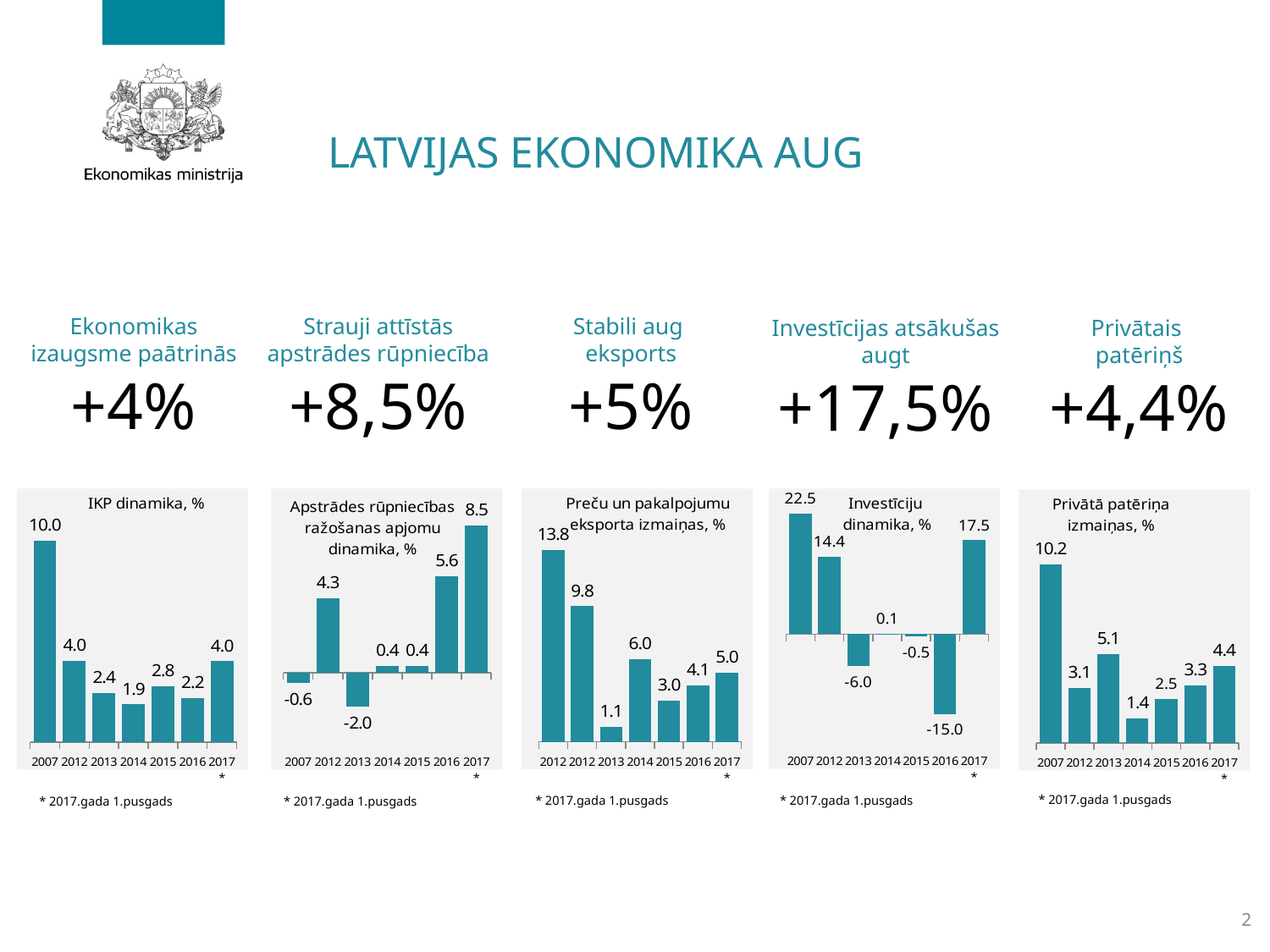
How many bars are plotted in the 'Privātā patēriņa izmaiņas, %' chart? 7 In the 'Preču un pakalpojumu eksporta izmaiņas, %' chart, which is larger, the value for 2015 or the value for 2016? 2016 In the 'Investīciju dinamika, %' chart, what is the value for 2016? -15.0 In the 'IKP dinamika, %' chart, which year has the lowest value? 2014 In the 'Apstrādes rūpniecības ražošanas apjomu dinamika, %' chart, what is the value for 2017? 8.5 In the 'Apstrādes rūpniecības ražošanas apjomu dinamika, %' chart, which year has the lowest value? 2013 In the 'Privātā patēriņa izmaiņas, %' chart, what is the value for 2013? 5.1 In the 'Investīciju dinamika, %' chart, which year has the highest value? 2007 What type of chart is the 'IKP dinamika, %' chart? Bar chart In the 'IKP dinamika, %' chart, what is the value for 2007? 10.0 In the 'Preču un pakalpojumu eksporta izmaiņas, %' chart, what is the value for 2014? 6.0 In the 'Apstrādes rūpniecības ražošanas apjomu dinamika, %' chart, what is the difference between the 2017 value and the 2016 value? 2.9